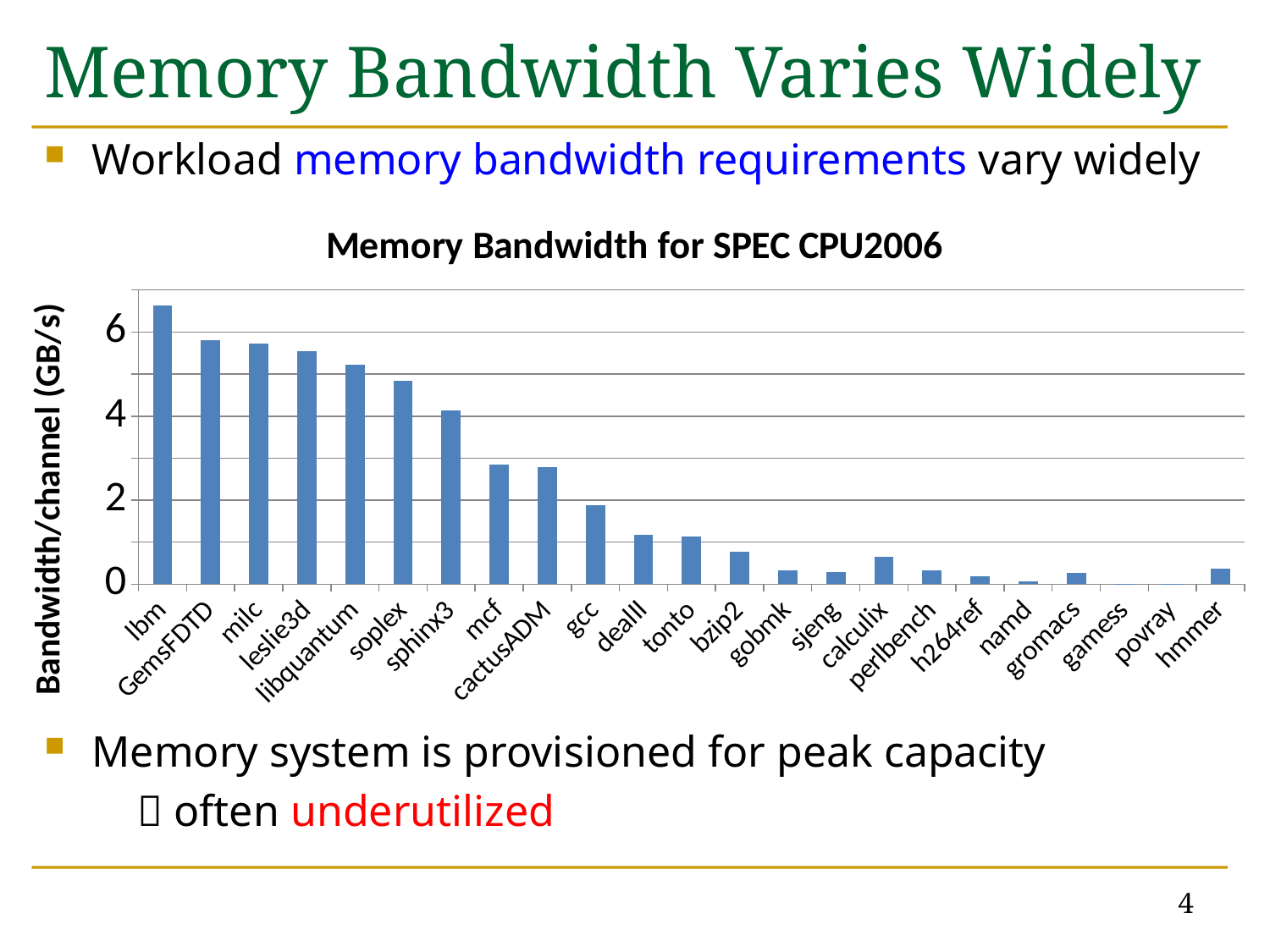
Is the value for gcc greater or less than 2? less Which has the larger value, soplex or sphinx3? soplex How many benchmarks are plotted on the x axis? 23 What kind of chart is shown on the slide? bar chart What is the title of the chart? Memory Bandwidth for SPEC CPU2006 Is the value for lbm greater or less than 6? greater Is the value for GemsFDTD greater or less than 6? less Do the values generally rise or fall from left to right along the x axis? fall Which benchmark has the highest memory bandwidth? lbm What is the label of the vertical axis? Bandwidth/channel (GB/s)